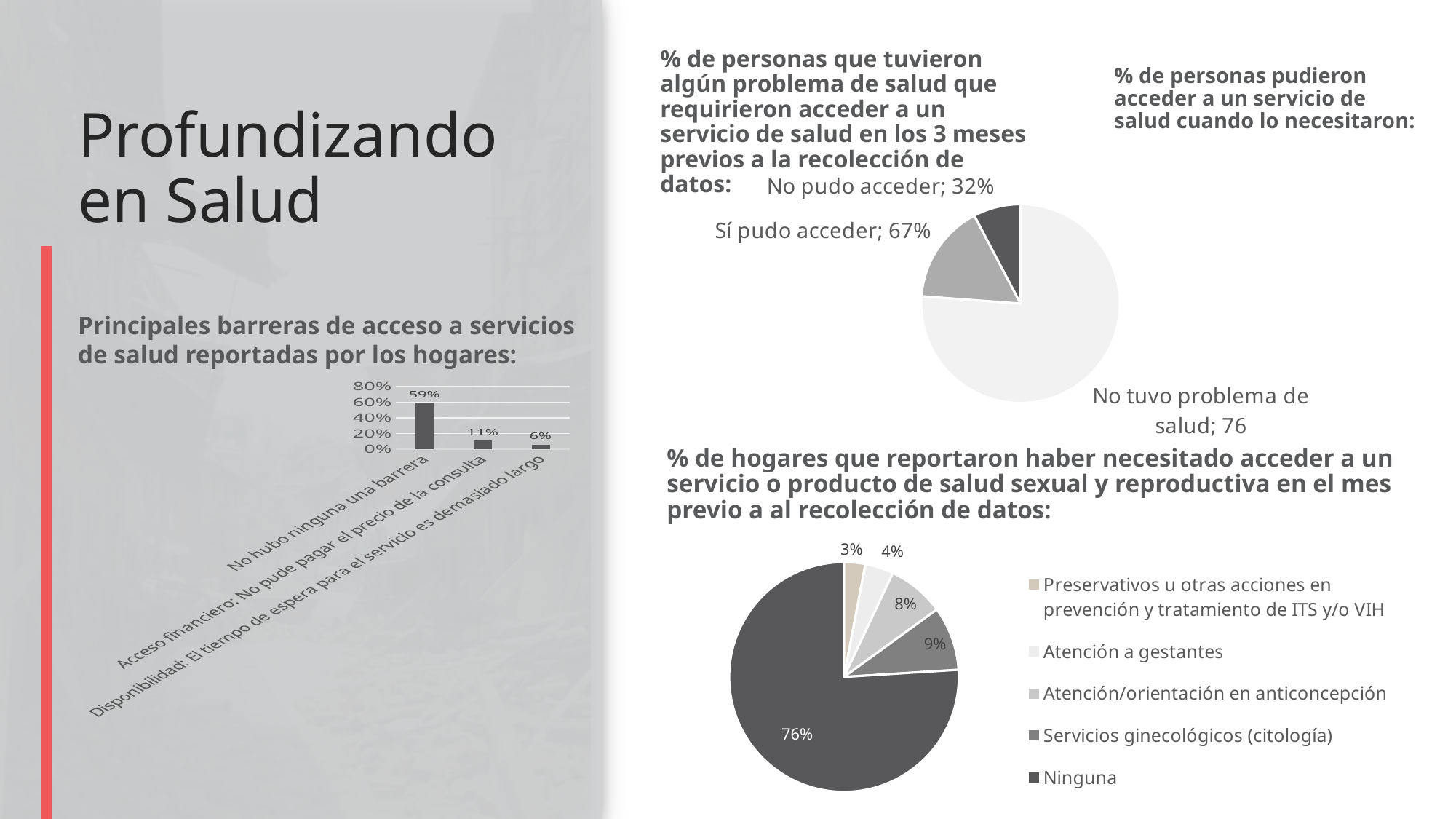
In the pie chart at the top right of the slide, which slice is the largest? No tuvo problema de salud In the pie chart at the top right of the slide, what is the value for 'No pudo acceder'? 32% In the bar chart 'Principales barreras de acceso a servicios de salud reportadas por los hogares', what is the value for 'No hubo ninguna una barrera'? 59% In the bar chart 'Principales barreras de acceso a servicios de salud reportadas por los hogares', what is the difference between 'No hubo ninguna una barrera' and 'Acceso financiero: No pude pagar el precio de la consulta'? 48% In the pie chart '% de hogares que reportaron haber necesitado acceder a un servicio o producto de salud sexual y reproductiva', what share does 'Ninguna' have? 76% How many categories does the bar chart 'Principales barreras de acceso a servicios de salud reportadas por los hogares' show? 3 In the bar chart 'Principales barreras de acceso a servicios de salud reportadas por los hogares', what is the value for 'Acceso financiero: No pude pagar el precio de la consulta'? 11% In the bar chart 'Principales barreras de acceso a servicios de salud reportadas por los hogares', which category has the lowest value? Disponibilidad: El tiempo de espera para el servicio es demasiado largo What kind of chart is the chart 'Principales barreras de acceso a servicios de salud reportadas por los hogares'? bar chart In the pie chart at the top right of the slide, what is the value for 'Sí pudo acceder'? 67% How many entries does the legend of the pie chart '% de hogares que reportaron haber necesitado acceder a un servicio o producto de salud sexual y reproductiva' list? 5 In the pie chart '% de hogares que reportaron haber necesitado acceder a un servicio o producto de salud sexual y reproductiva', what is the value for 'Servicios ginecológicos (citología)'? 9%